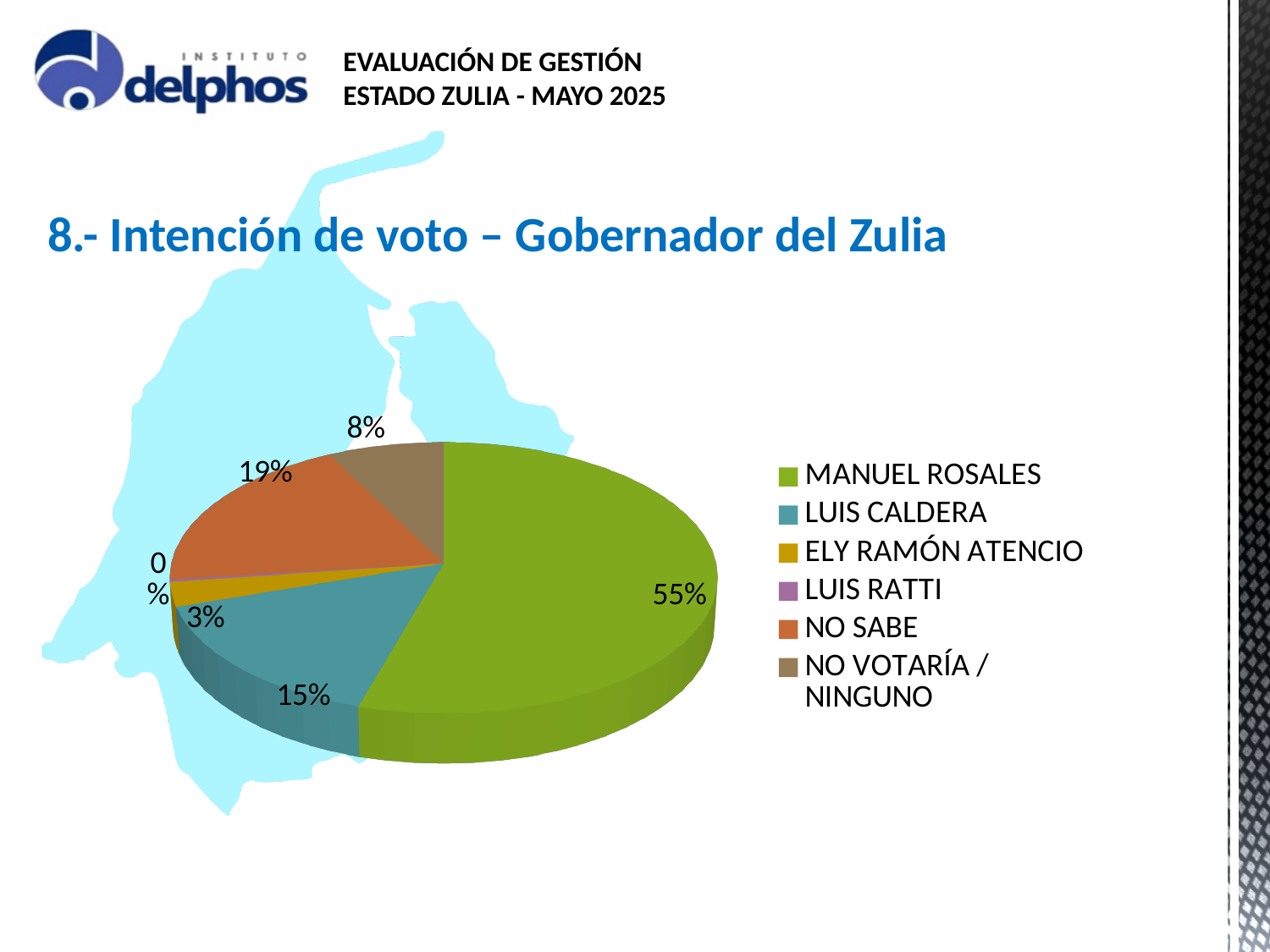
What is the difference between the shares of MANUEL ROSALES and LUIS CALDERA? 40% Which is larger, the share for NO SABE or the share for LUIS CALDERA? NO SABE What colour is the slice for NO SABE? Orange Which category has the largest slice of the pie? MANUEL ROSALES What share of the pie does LUIS CALDERA have? 15% What kind of chart is shown on the slide? Pie chart What share of the pie does MANUEL ROSALES have? 55% How many categories does the legend list? 6 What share of the pie does ELY RAMÓN ATENCIO have? 3% Which category has the smallest slice of the pie? LUIS RATTI What share of the pie does NO VOTARÍA / NINGUNO have? 8% What share of the pie does NO SABE have? 19%